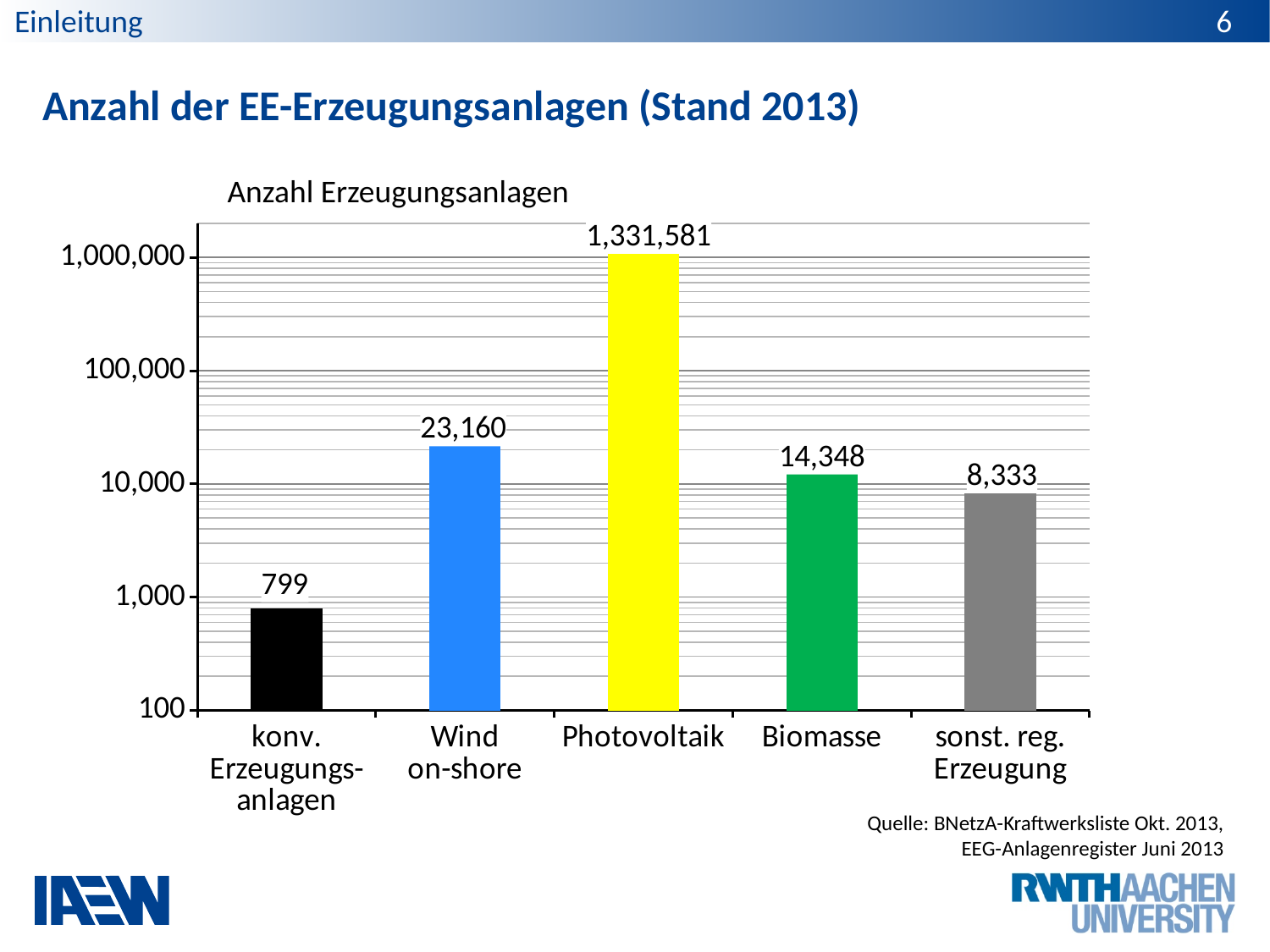
What kind of chart is shown? bar chart What is the title of the chart? Anzahl Erzeugungsanlagen Which category has the lowest value? konv. Erzeugungsanlagen Is the value for sonst. reg. Erzeugung greater or less than 10,000? less What is the value for Biomasse? 14,348 What is the value for konv. Erzeugungsanlagen? 799 What is the value for Photovoltaik? 1,331,581 What is the value for Wind on-shore? 23,160 Which category has the highest value? Photovoltaik What is the difference between the values for Wind on-shore and Biomasse? 8,812 Which is larger, the value for Biomasse or the value for sonst. reg. Erzeugung? Biomasse How many categories are shown on the x axis? 5